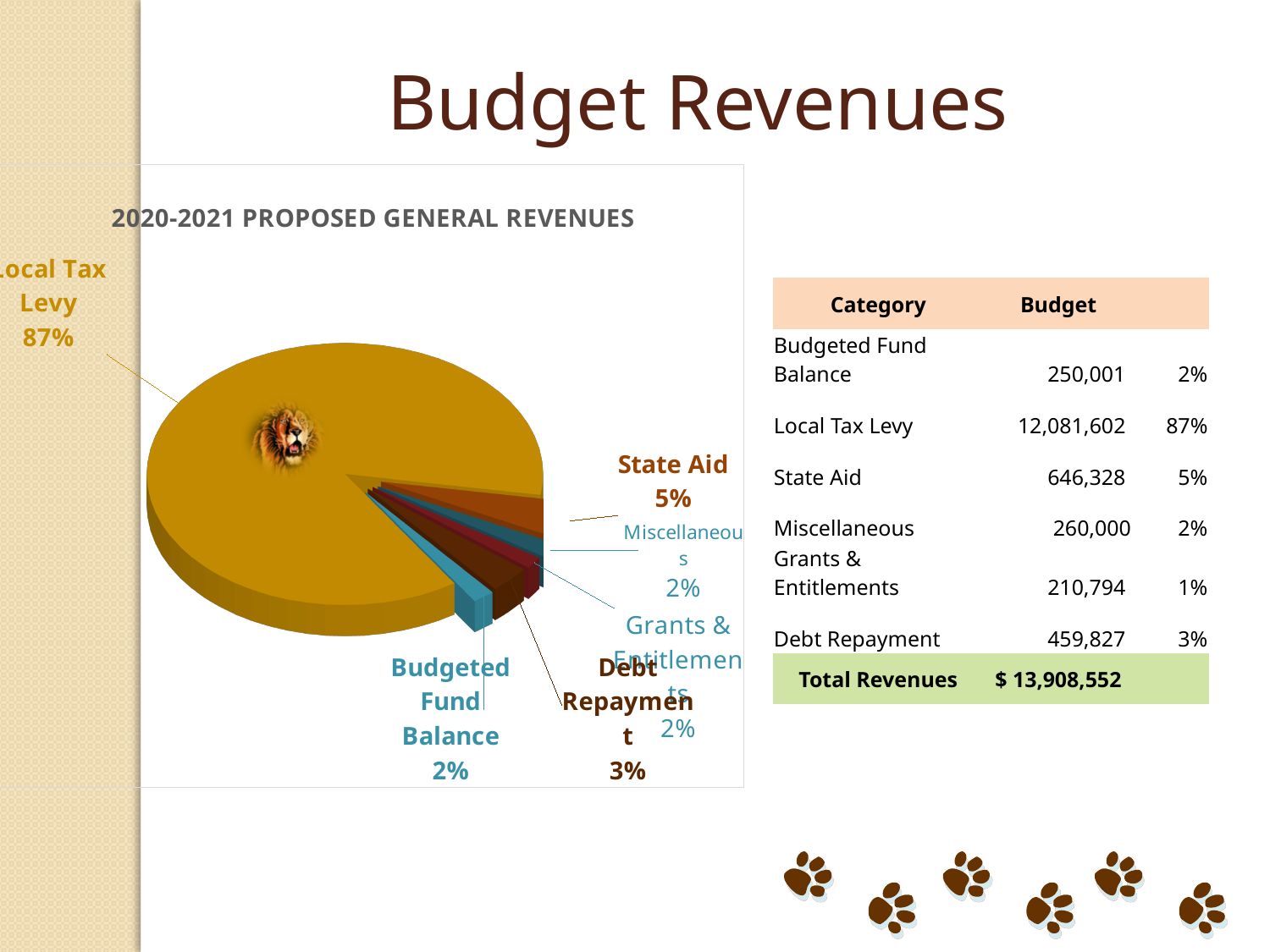
What is the title of the chart? 2020-2021 PROPOSED GENERAL REVENUES What share of the pie does Miscellaneous represent? 2% What share of the pie does State Aid represent? 5% What share of the pie does Debt Repayment represent? 3% What is the difference in percentage points between the Debt Repayment slice and the Budgeted Fund Balance slice? 1% What kind of chart is shown on the slide? pie chart Which is larger, the State Aid slice or the Debt Repayment slice? State Aid Which category has the largest slice of the pie? Local Tax Levy What is the difference in percentage points between the Local Tax Levy slice and the State Aid slice? 82% How many slices does the pie chart have? 6